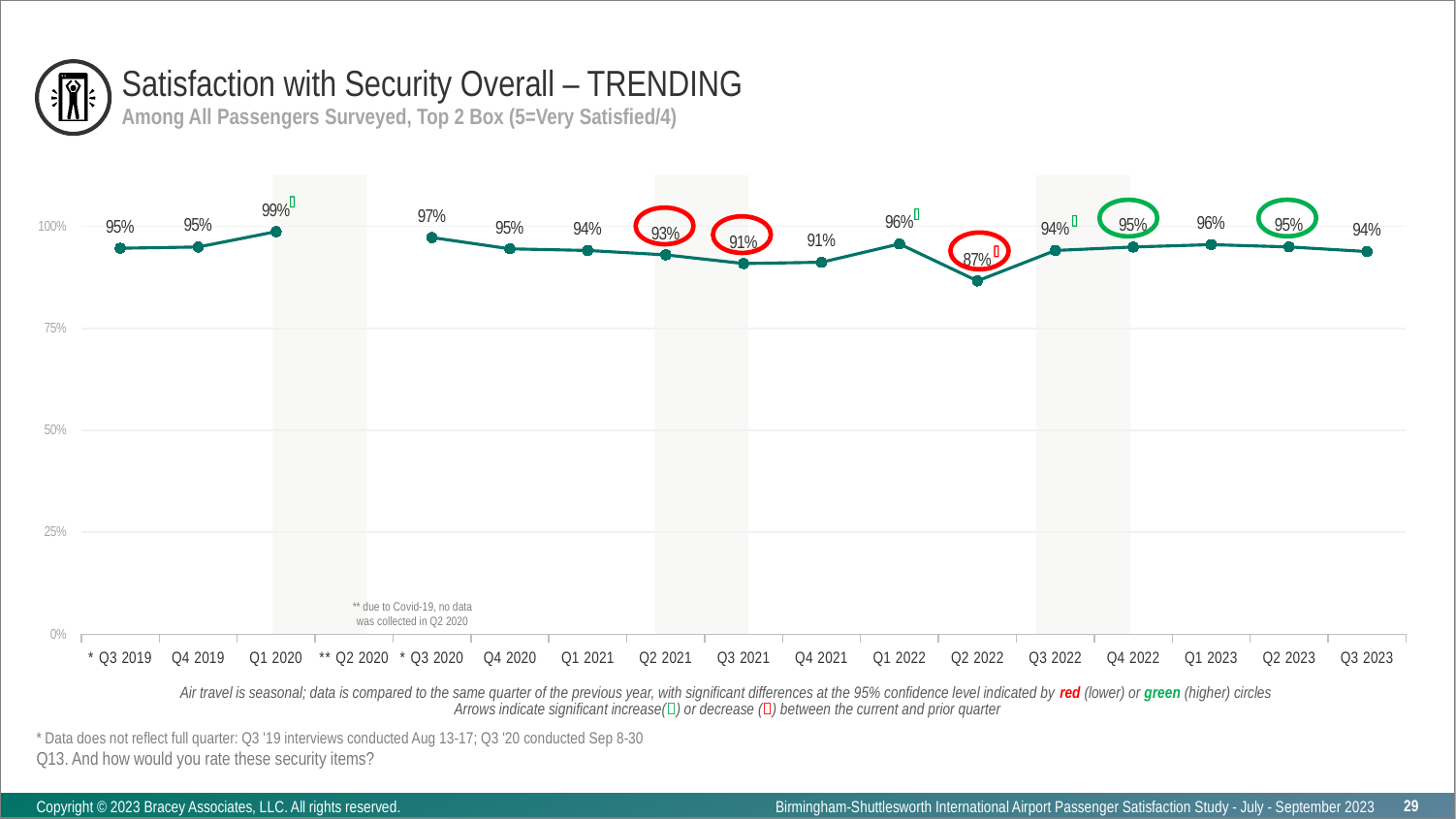
What kind of chart is shown on the slide? line chart Which quarter has the highest satisfaction value? Q1 2020 For which quarter was no data collected due to Covid-19? Q2 2020 Is the value for Q2 2022 greater or less than 75%? greater What is the difference between the values for Q1 2022 and Q2 2022? 9 percentage points Which quarter has the lowest satisfaction value? Q2 2022 What is the satisfaction value for Q2 2022? 87% What is the satisfaction value for Q3 2021? 91% What is the satisfaction value for Q1 2020? 99% Which is larger, the value for Q3 2020 or the value for Q4 2020? Q3 2020 What is the satisfaction value for Q3 2023? 94% How many quarters are labelled on the x axis? 17